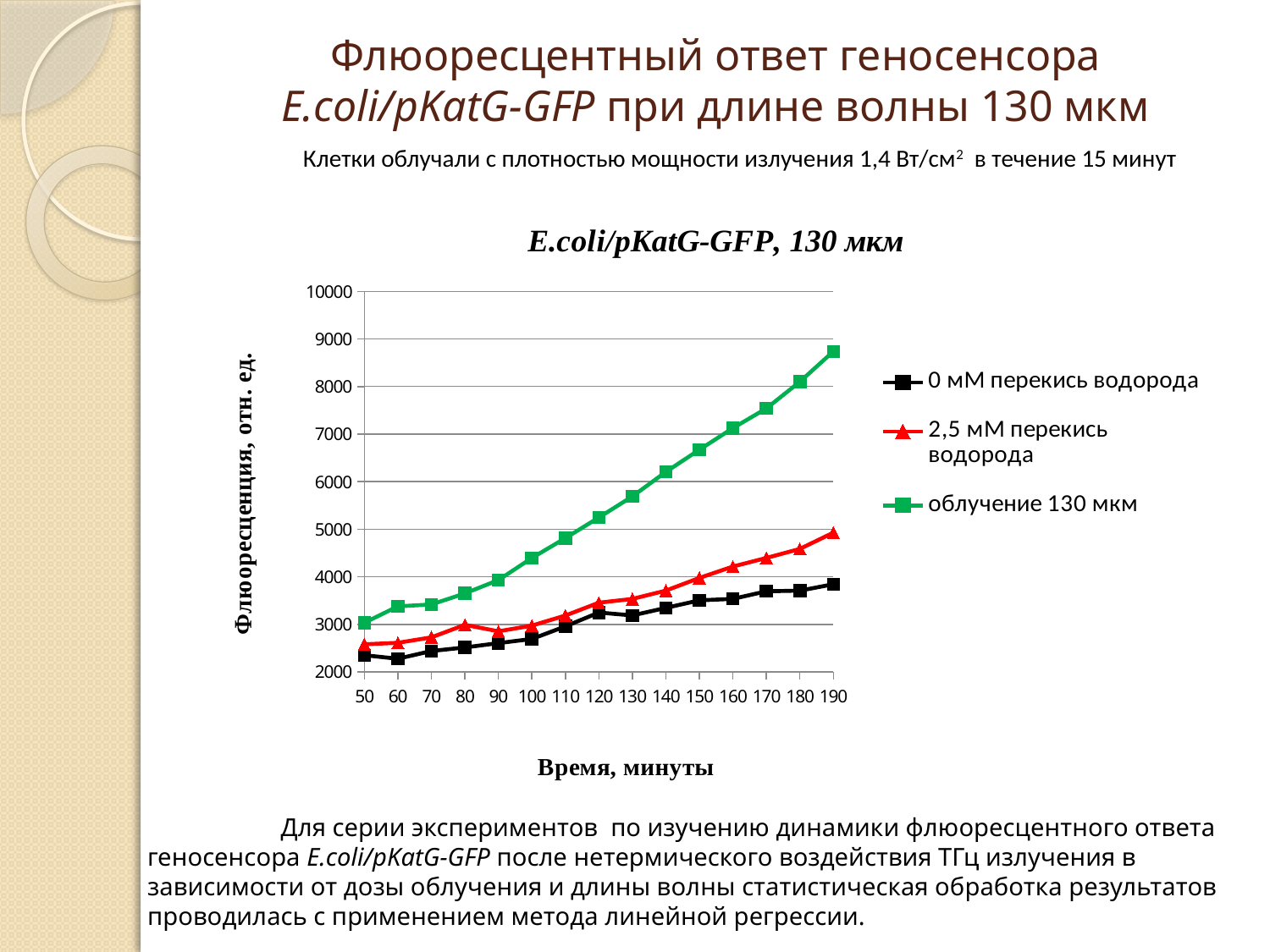
Which series reaches the highest fluorescence value on the chart? облучение 130 мкм What is the label of the y axis of the chart? Флюоресценция, отн. ед. What kind of chart is shown on the slide? line chart Which series has the lowest value at 190 minutes? 0 мМ перекись водорода How many time points are plotted along the x axis of the chart? 15 How many series does the legend of the chart list? 3 Is the value for "облучение 130 мкм" at 100 minutes greater or less than 4000? greater Does the series "облучение 130 мкм" rise or fall as time increases along the x axis? rises Is the value for "облучение 130 мкм" at 190 minutes greater or less than 8000? greater Is the value for "0 мМ перекись водорода" at 50 minutes greater or less than 3000? less What is the title of the chart? E.coli/pKatG-GFP, 130 мкм At 190 minutes, which is larger: the value for "облучение 130 мкм" or for "2,5 мМ перекись водорода"? облучение 130 мкм